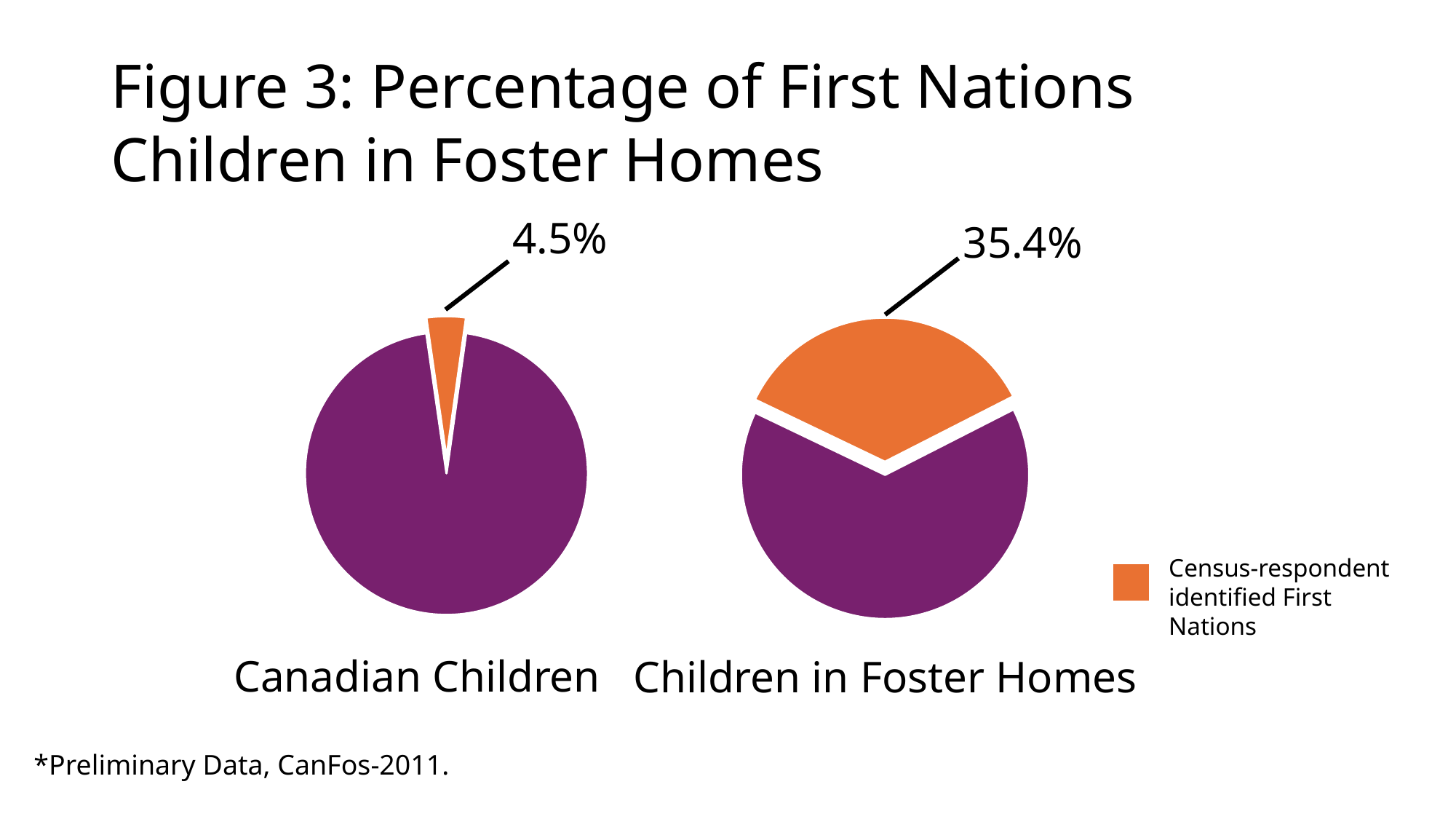
What kind of charts are shown on the slide? Pie charts What label does the legend give to the orange colour? Census-respondent identified First Nations What is the title of the figure on the slide? Figure 3: Percentage of First Nations Children in Foster Homes Which pie chart has the larger Census-respondent identified First Nations slice, Canadian Children or Children in Foster Homes? Children in Foster Homes In the Children in Foster Homes pie chart, what share of the pie does the orange slice represent? 35.4% In the Canadian Children pie chart, what share of the pie does the orange slice represent? 4.5% In the Canadian Children pie chart, what percentage is shown for the Census-respondent identified First Nations slice? 4.5% How many entries does the legend list? 1 What is the difference between the First Nations percentage in the Children in Foster Homes chart and the Canadian Children chart? 30.9% In the Children in Foster Homes pie chart, what percentage is shown for the Census-respondent identified First Nations slice? 35.4% How many pie charts are on the slide? 2